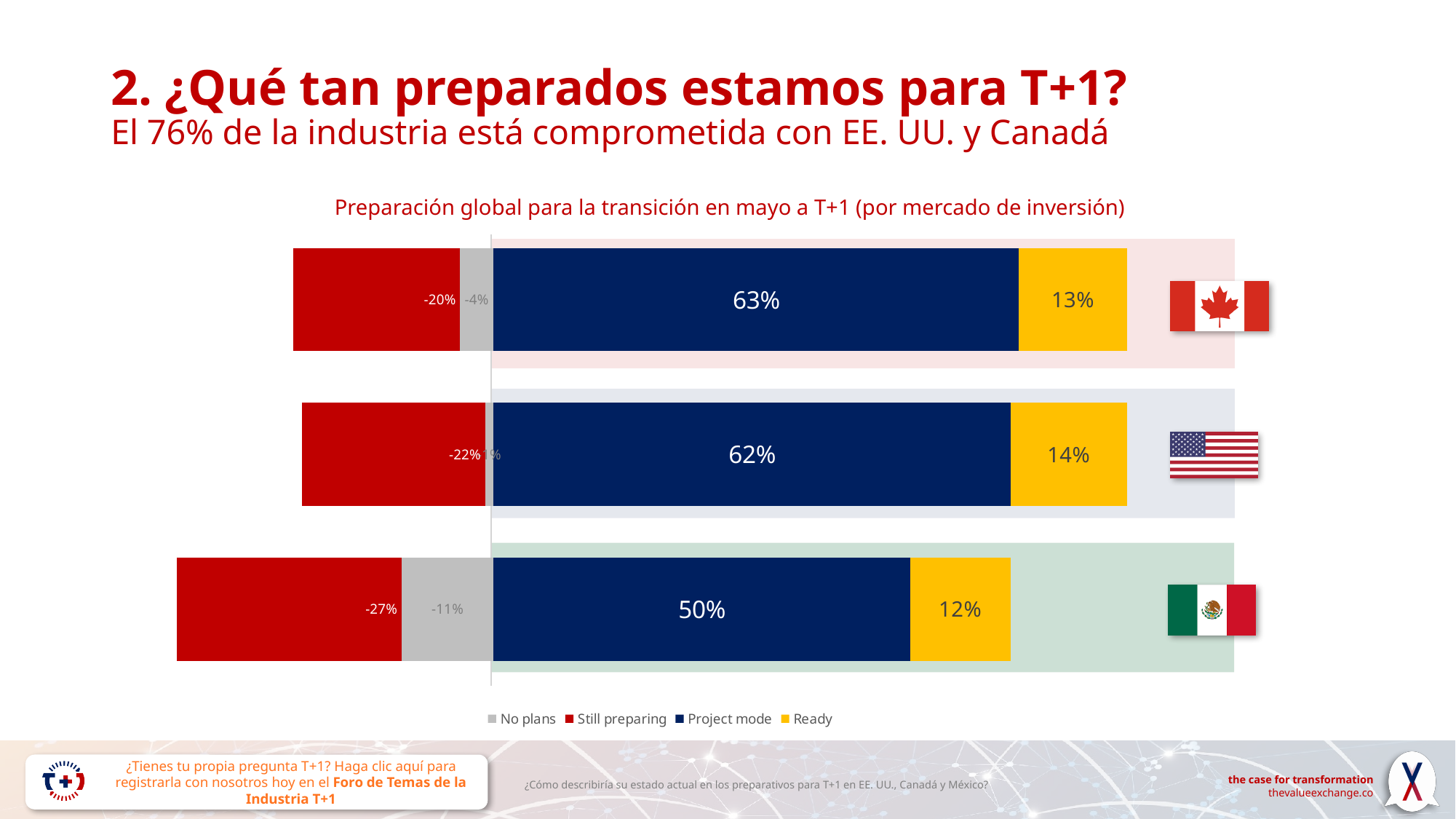
What kind of chart is shown on the slide? Stacked bar chart What is the title of the chart? Preparación global para la transición en mayo a T+1 (por mercado de inversión) How many markets (bars) are shown in the chart? 3 Which market has the lowest 'Ready' value? Mexico What is the difference between the 'Project mode' values for Canada and Mexico? 13 percentage points Which market has the highest 'Project mode' value? Canada What is the 'Project mode' value for Canada? 63% What is the 'Ready' value for the United States? 14% What is the 'Still preparing' value for Mexico? -27% What is the 'No plans' value for Mexico? -11% How many series does the chart legend list? 4 Which has a larger 'Ready' value, the United States or Canada? United States